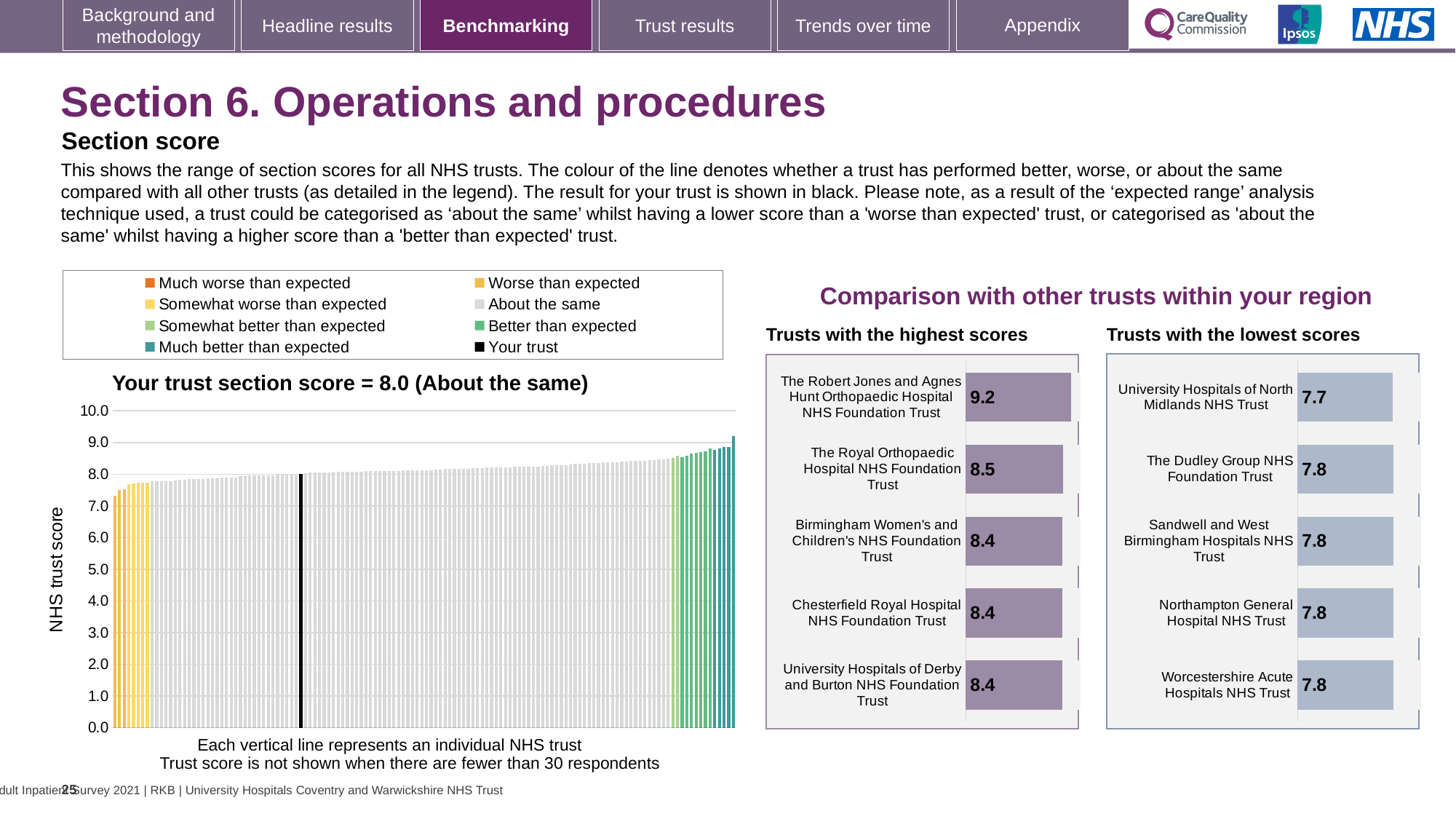
In the 'Trusts with the lowest scores' chart, which trust has the lowest score? University Hospitals of North Midlands NHS Trust In the 'Trusts with the highest scores' chart, what is the difference between the scores of The Robert Jones and Agnes Hunt Orthopaedic Hospital NHS Foundation Trust and The Royal Orthopaedic Hospital NHS Foundation Trust? 0.7 In the 'Your trust section score' chart, what is the section score for your trust? 8.0 In the 'Trusts with the highest scores' chart, which trust has the highest score? The Robert Jones and Agnes Hunt Orthopaedic Hospital NHS Foundation Trust In the 'Trusts with the highest scores' chart, what is the score for The Robert Jones and Agnes Hunt Orthopaedic Hospital NHS Foundation Trust? 9.2 What is the y-axis label of the 'Your trust section score' chart? NHS trust score In the 'Your trust section score' chart, do the trust scores rise or fall from left to right along the x axis? rise In the 'Trusts with the highest scores' chart, how many trusts are shown? 5 What kind of chart is the 'Your trust section score' chart? bar chart In the 'Trusts with the lowest scores' chart, what is the score for Worcestershire Acute Hospitals NHS Trust? 7.8 In the 'Your trust section score' chart, is the value of the lowest-scoring trust (leftmost bar) greater or less than 7.0? greater How many entries does the legend above the 'Your trust section score' chart list? 8